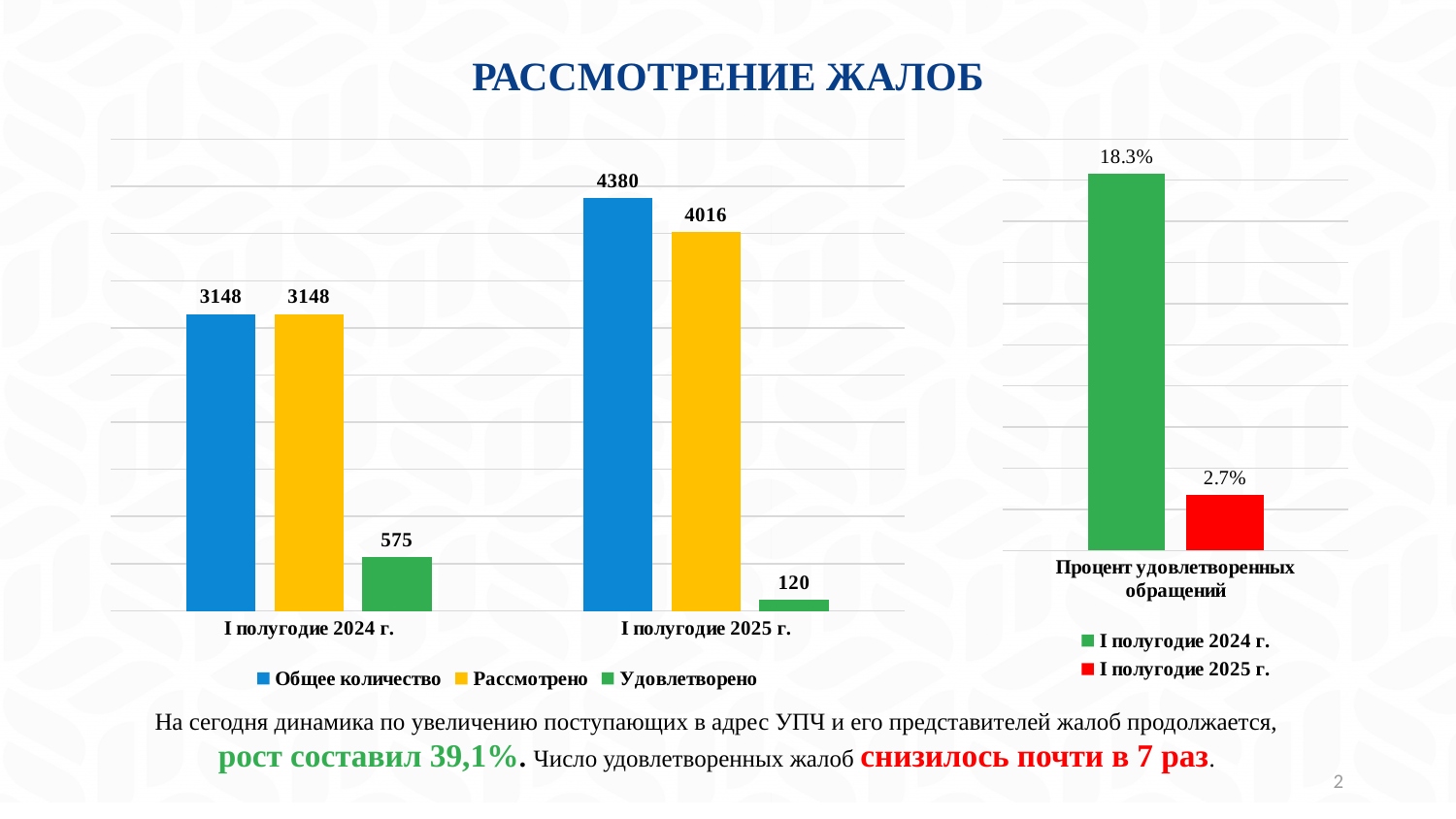
In the left chart, what is the value of "Удовлетворено" for "I полугодие 2024 г."? 575 In the right chart "Процент удовлетворенных обращений", what colour is the bar for "I полугодие 2025 г."? Red In the right chart "Процент удовлетворенных обращений", what is the value for "I полугодие 2024 г."? 18.3% In the right chart "Процент удовлетворенных обращений", which period has the highest value? I полугодие 2024 г. In the left chart, which series has the lowest value for "I полугодие 2025 г."? Удовлетворено How many series does the legend of the left chart list? 3 In the left chart, is "Удовлетворено" larger for "I полугодие 2024 г." or for "I полугодие 2025 г."? I полугодие 2024 г. What kind of chart is the left chart? Bar chart In the right chart "Процент удовлетворенных обращений", what is the value for "I полугодие 2025 г."? 2.7% In the left chart, what is the value of "Рассмотрено" for "I полугодие 2025 г."? 4016 In the left chart, what is the value of "Общее количество" for "I полугодие 2025 г."? 4380 In the left chart, what is the difference between "Общее количество" for "I полугодие 2025 г." and for "I полугодие 2024 г."? 1232